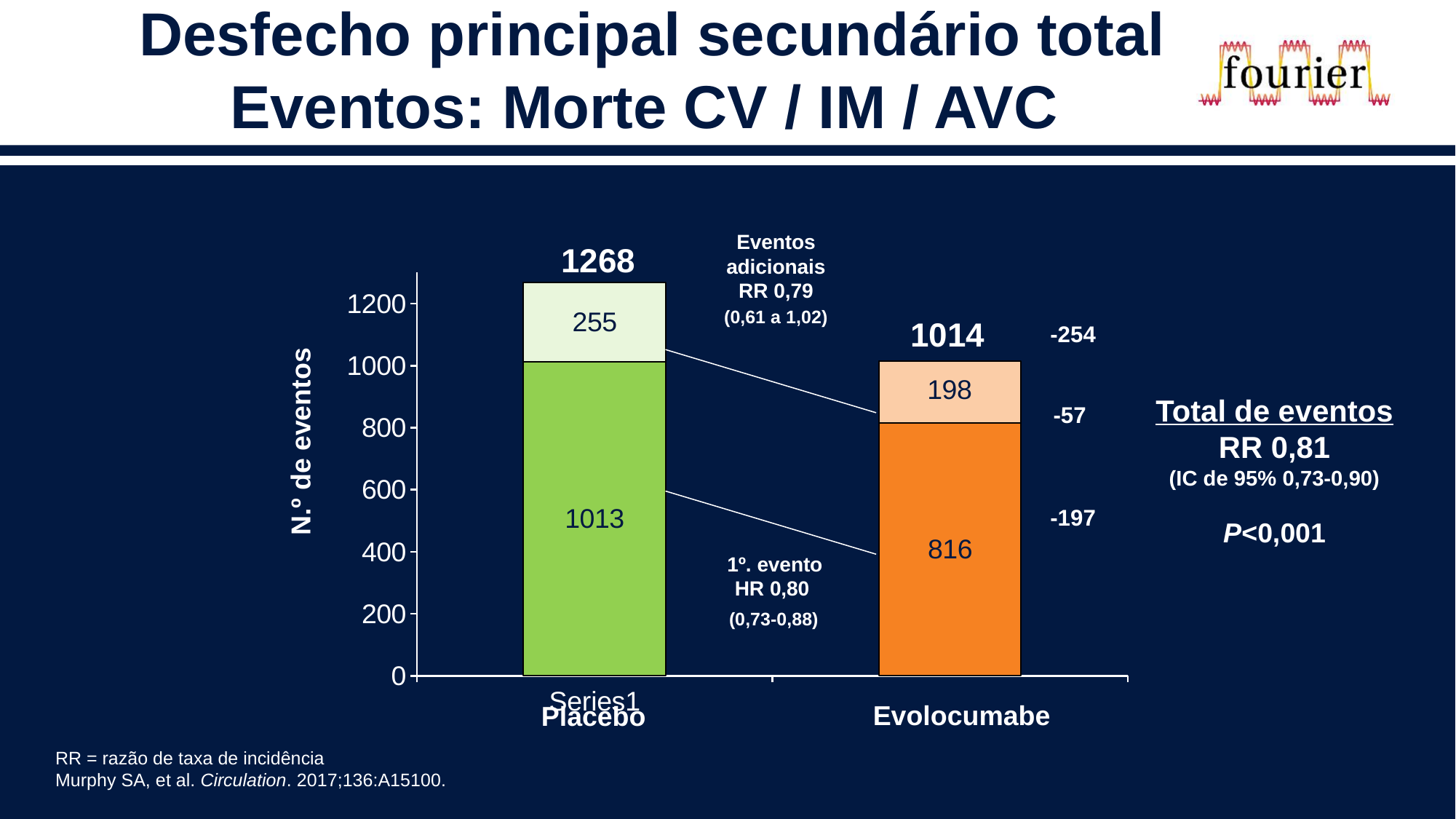
Which bar has the higher total number of events, Placebo or Evolocumabe? Placebo What is the difference between the additional-events segments of Placebo (255) and Evolocumabe (198)? 57 What type of chart is shown on the slide? stacked bar chart What is the value of the lower (first event) segment of the Evolocumabe bar? 816 How many bars (treatment groups) are shown in the chart? 2 What is the value of the upper (additional events) segment of the Evolocumabe bar? 198 What is the difference between the first-event segments of Placebo (1013) and Evolocumabe (816)? 197 What is the label of the y axis? N.º de eventos What is the total number of events for the Evolocumabe bar? 1014 What is the total number of events for the Placebo bar? 1268 What is the value of the upper (additional events) segment of the Placebo bar? 255 What is the value of the lower (first event) segment of the Placebo bar? 1013